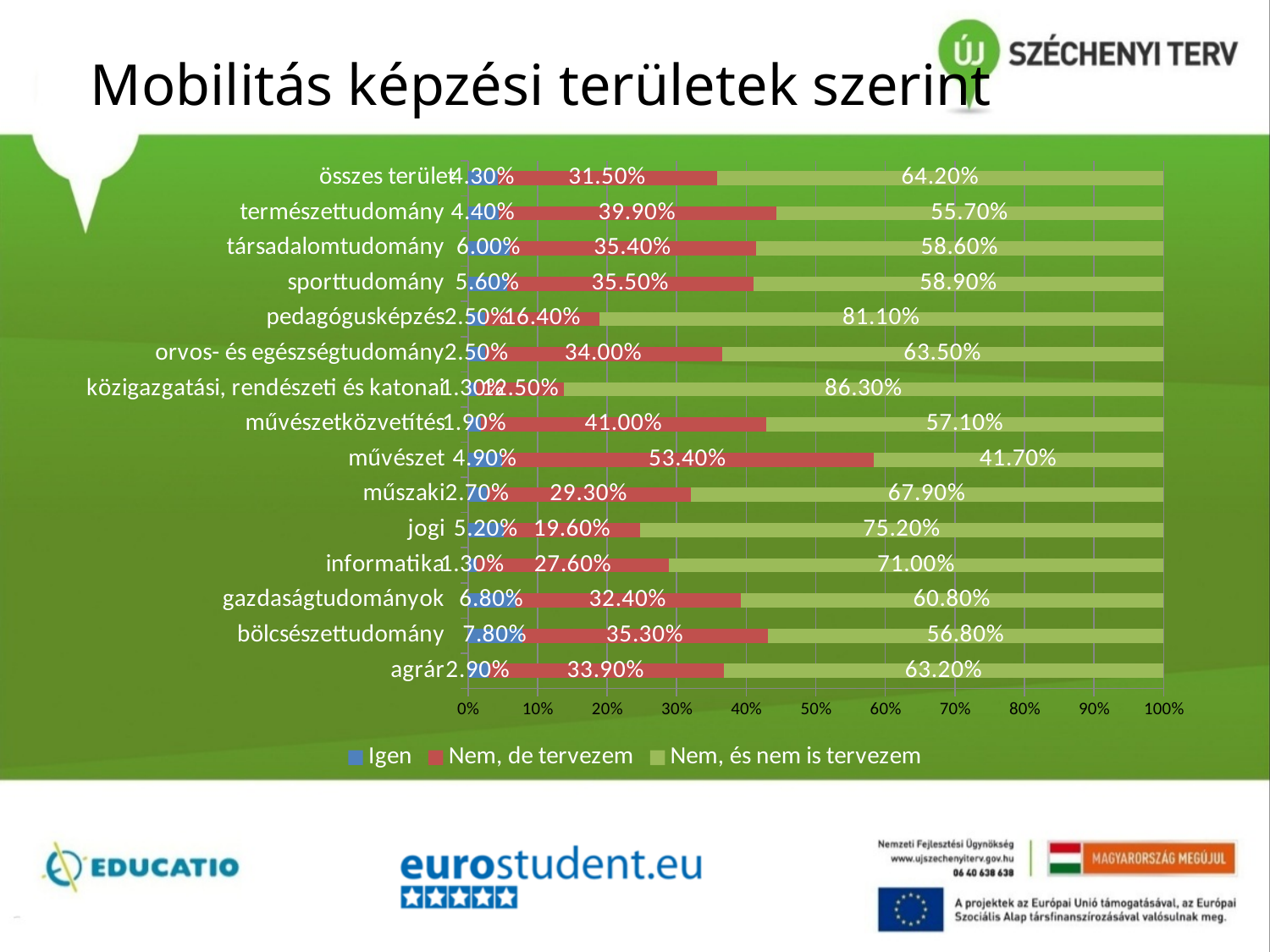
What is the value of 'Nem, de tervezem' for művészet? 53.40% Which category has the highest 'Igen' value? bölcsészettudomány What type of chart is shown on the slide? bar chart What is the third legend entry of the chart? Nem, és nem is tervezem Which category has the highest 'Nem, és nem is tervezem' value? közigazgatási, rendészeti és katonai What is the value of 'Igen' for bölcsészettudomány? 7.80% What is the value of 'Nem, és nem is tervezem' for pedagógusképzés? 81.10% What is the difference between the 'Nem, de tervezem' values for természettudomány and jogi? 20.30% How many categories (training areas) are shown on the chart? 15 Which is larger: the 'Nem, de tervezem' value for művészetközvetítés or for műszaki? művészetközvetítés Which category has the lowest 'Nem, és nem is tervezem' value? művészet How many series does the legend list? 3